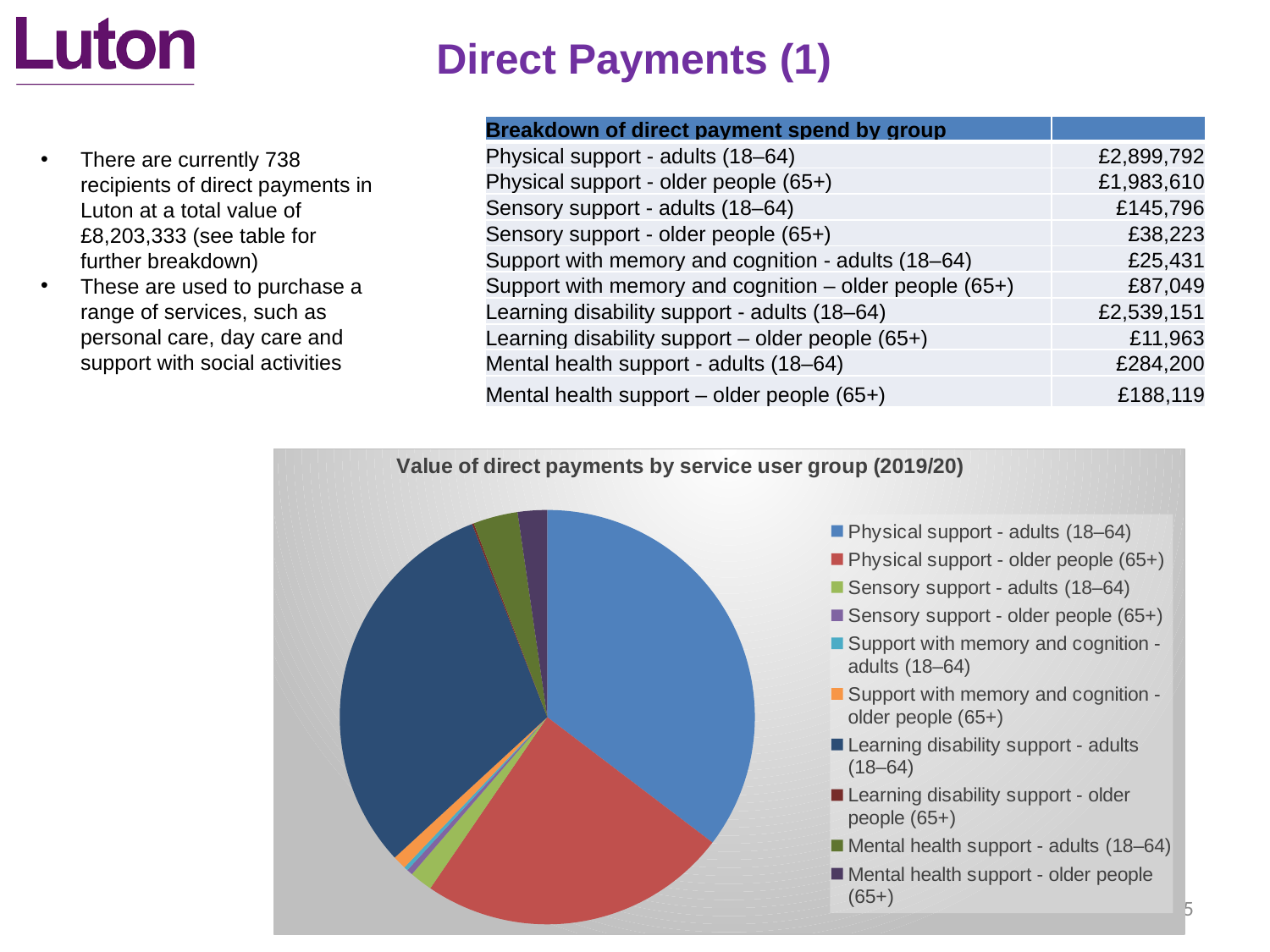
Which slice is larger in the pie chart: Physical support - older people (65+) or Mental health support - adults (18–64)? Physical support - older people (65+) According to the table on the slide, what is the direct payment spend for Physical support - adults (18–64)? £2,899,792 According to the table on the slide, what is the direct payment spend for Learning disability support - adults (18–64)? £2,539,151 Which slice is larger in the pie chart: Learning disability support - adults (18–64) or Sensory support - adults (18–64)? Learning disability support - adults (18–64) Using the values in the table, how much more is spent on Physical support - adults (18–64) than on Learning disability support - adults (18–64)? £360,641 How many service user groups (slices) does the pie chart show? 10 What colour is the slice for Physical support - older people (65+) in the pie chart? Red According to the table, which group has the lowest direct payment spend? Learning disability support – older people (65+) According to the table on the slide, what is the direct payment spend for Mental health support – older people (65+)? £188,119 What is the title of the pie chart? Value of direct payments by service user group (2019/20) What kind of chart is shown on the slide? Pie chart Which service user group has the largest slice of the pie chart? Physical support - adults (18–64)